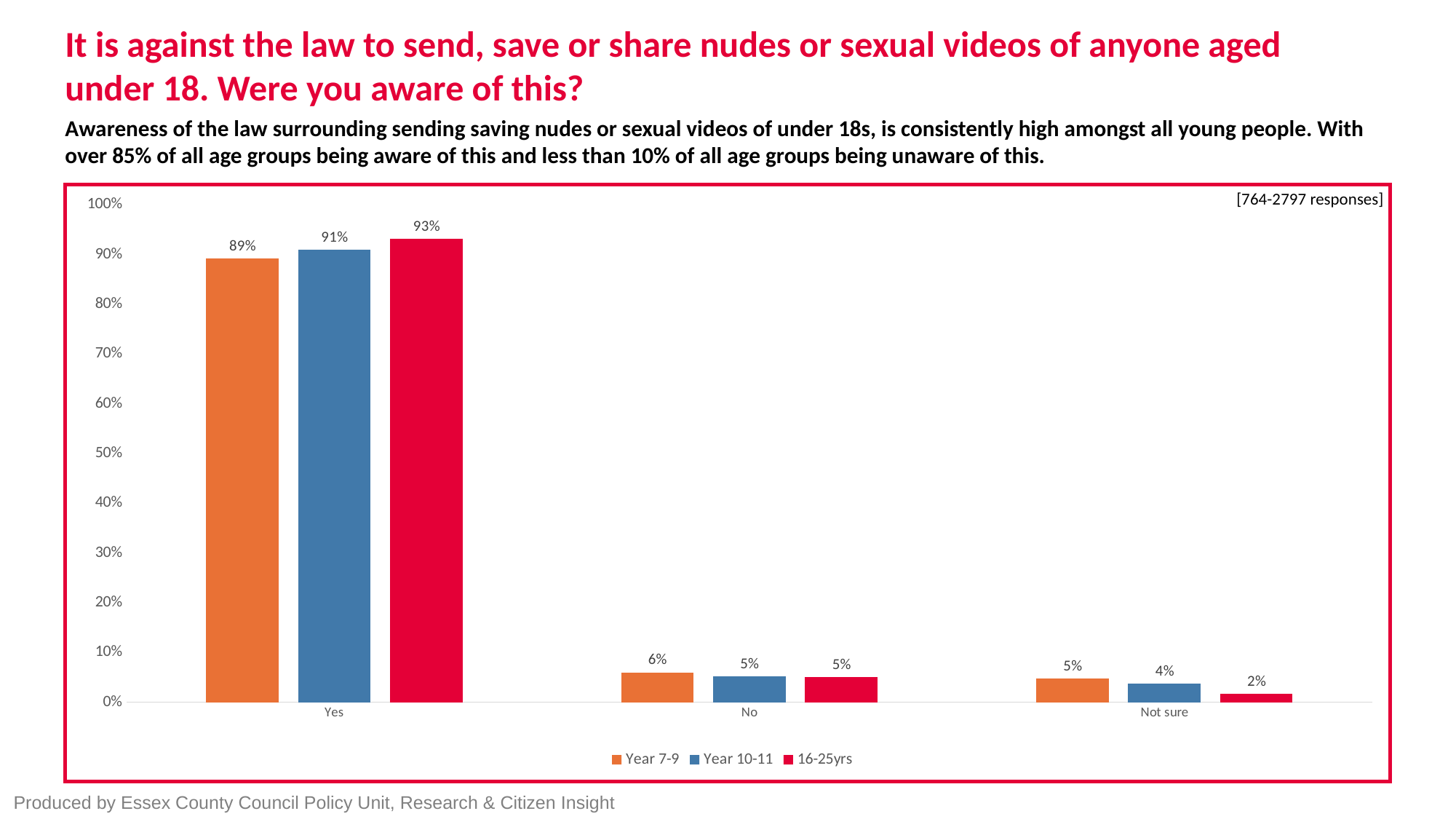
What kind of chart is shown on the slide? Bar chart What percentage of 16-25yrs respondents answered Not sure? 2% How many series does the legend list? 3 Which is larger: the Year 7-9 value for No or the Year 7-9 value for Not sure? Year 7-9 value for No Which colour represents the 16-25yrs series in the legend? Red Which age group has the highest percentage answering Yes? 16-25yrs Which age group has the lowest percentage answering Not sure? 16-25yrs What percentage of Year 10-11 respondents answered No? 5% What is the difference between the 16-25yrs and Year 7-9 percentages for Yes? 4% How many response categories are shown on the x axis? 3 What percentage of Year 7-9 respondents answered Yes? 89% Is the value for Year 10-11 answering Yes greater or less than 80%? greater